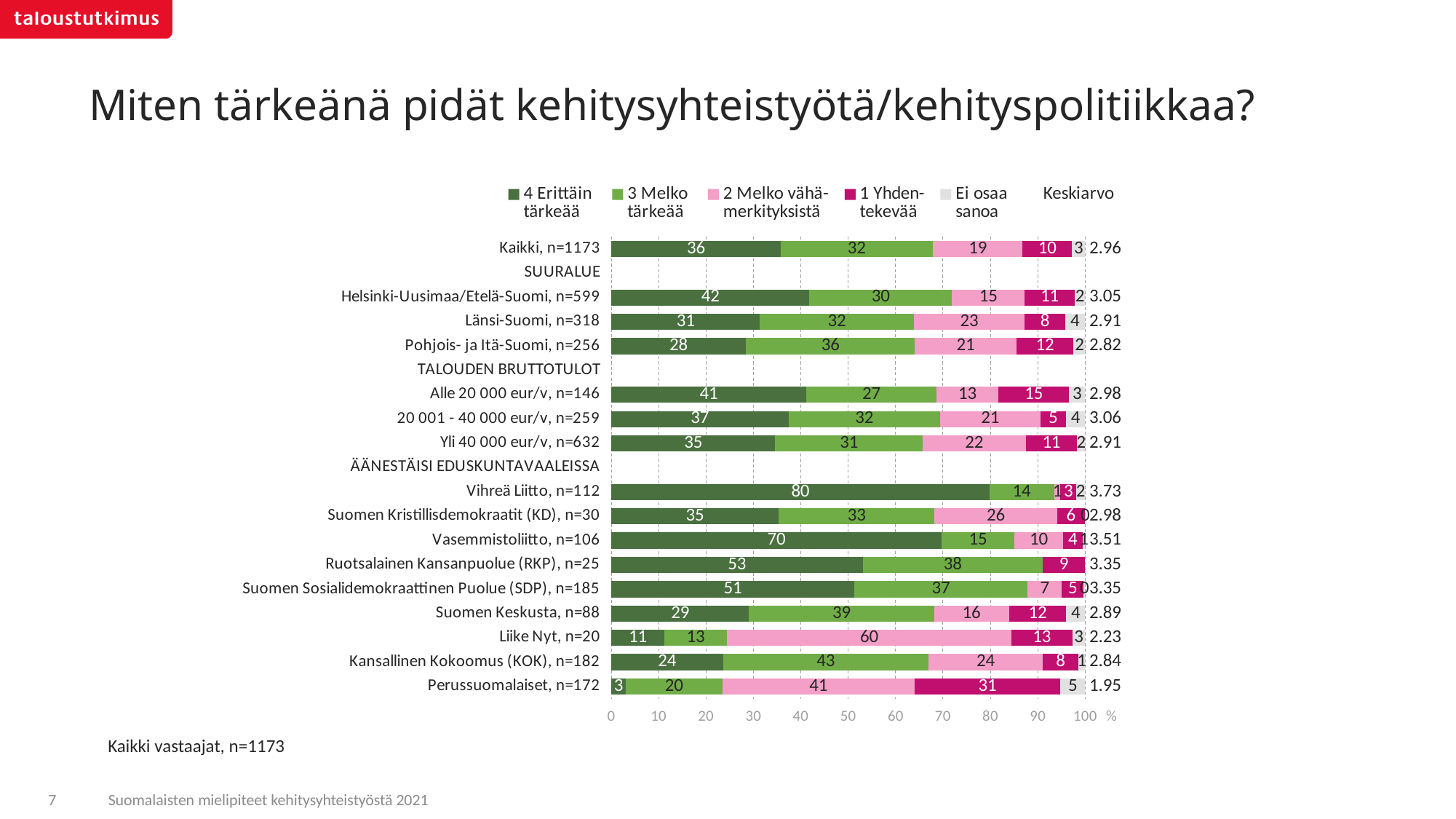
Which group has the lowest Keskiarvo (mean) value? Perussuomalaiset, n=172 What percentage of all respondents (Kaikki, n=1173) answered '4 Erittäin tärkeää'? 36 What is the Keskiarvo value for Vasemmistoliitto, n=106? 3.51 Which group has the highest share of '4 Erittäin tärkeää' answers? Vihreä Liitto, n=112 What percentage of Perussuomalaiset respondents (n=172) answered '1 Yhdentekevää'? 31 What is the title of the chart? Miten tärkeänä pidät kehitysyhteistyötä/kehityspolitiikkaa? What type of chart is shown on the slide? Stacked bar chart How many respondent groups (bars) are plotted in the chart? 16 How many percentage points higher is the '4 Erittäin tärkeää' share for Helsinki-Uusimaa/Etelä-Suomi than for Länsi-Suomi? 11 What is the highest Keskiarvo value shown in the chart? 3.73 Which has a larger '2 Melko vähämerkityksistä' share: Liike Nyt or Perussuomalaiset? Liike Nyt What percentage of Suomen Keskusta respondents (n=88) answered '3 Melko tärkeää'? 39